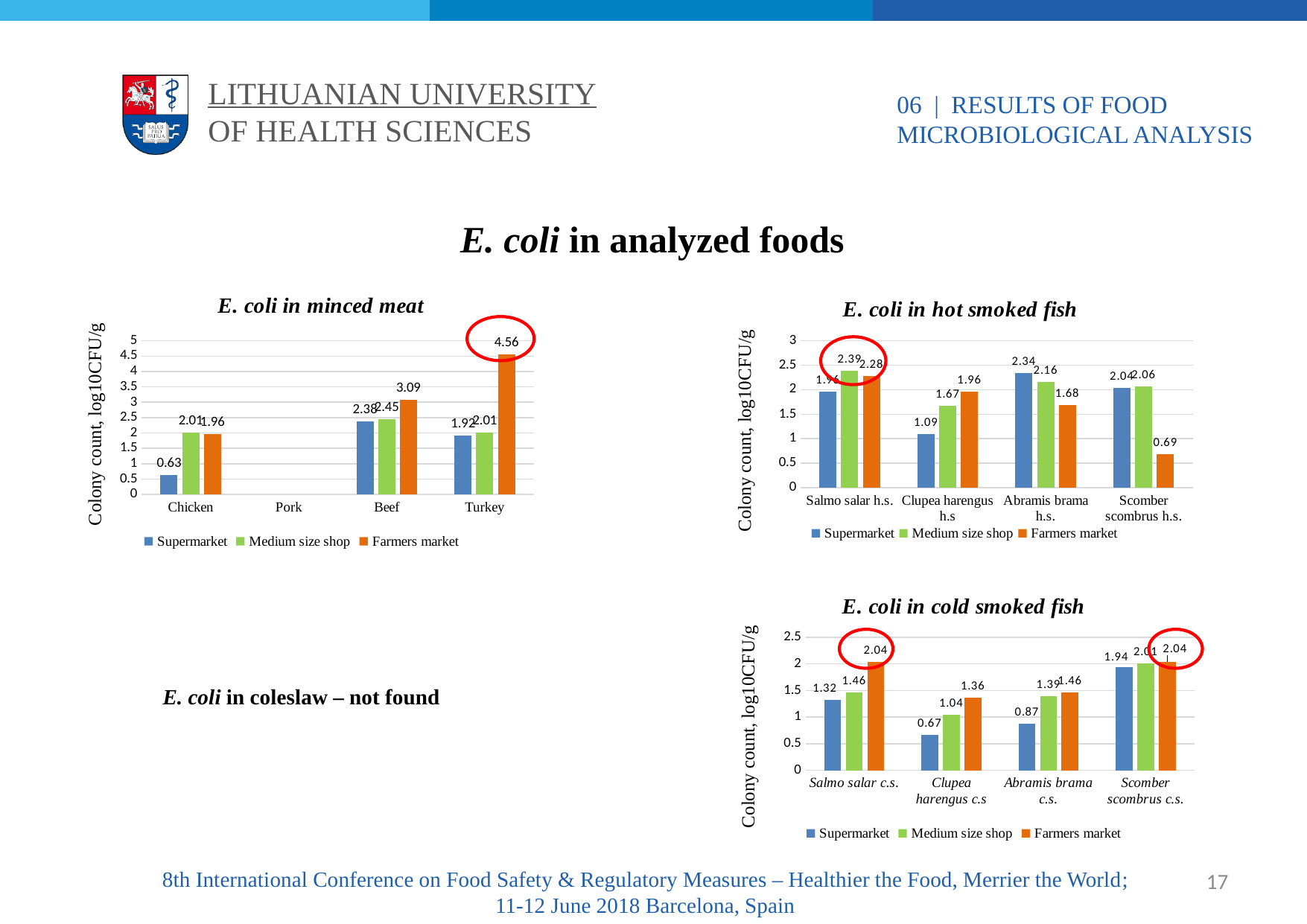
In the 'E. coli in minced meat' chart, how many series does the legend list? 3 In the 'E. coli in cold smoked fish' chart, what is the Supermarket value for Clupea harengus c.s? 0.67 In the 'E. coli in cold smoked fish' chart, how many categories are shown on the x axis? 4 In the 'E. coli in minced meat' chart, what is the Farmers market value for Turkey? 4.56 In the 'E. coli in minced meat' chart, what is the difference between the Farmers market and Supermarket values for Beef? 0.71 In the 'E. coli in minced meat' chart, what is the Supermarket value for Chicken? 0.63 In the 'E. coli in cold smoked fish' chart, which category has the highest Supermarket value? Scomber scombrus c.s. In the 'E. coli in hot smoked fish' chart, is the Supermarket value for Abramis brama h.s. greater or less than the Farmers market value? greater What type of chart is 'E. coli in cold smoked fish'? bar chart In the 'E. coli in cold smoked fish' chart, what is the difference between the Farmers market and Supermarket values for Salmo salar c.s.? 0.72 In the 'E. coli in hot smoked fish' chart, which category has the lowest Supermarket value? Clupea harengus h.s In the 'E. coli in hot smoked fish' chart, what is the Farmers market value for Scomber scombrus h.s.? 0.69